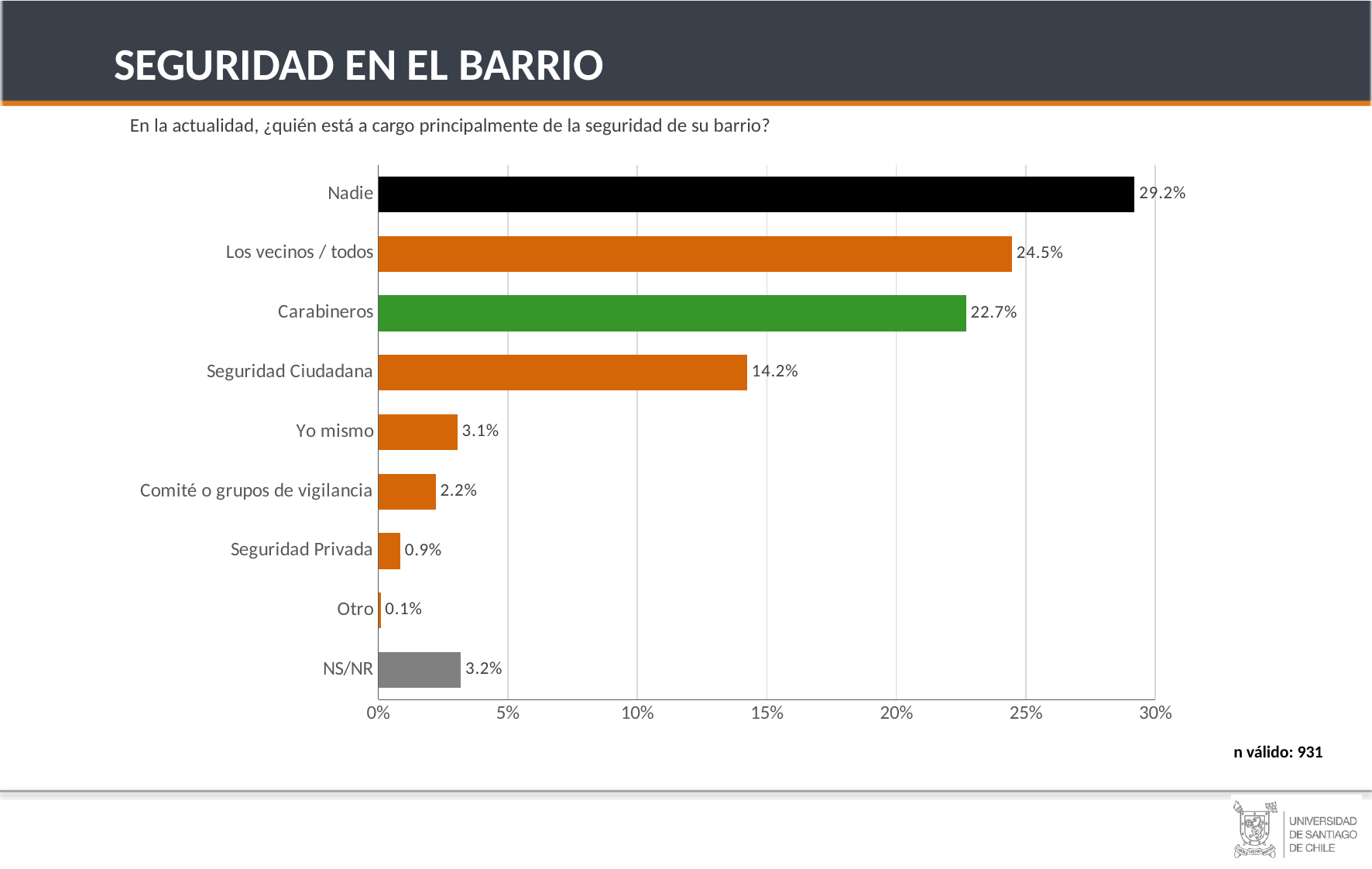
What kind of chart is shown on the slide? bar chart What is the difference between the values for "Nadie" and "Los vecinos / todos"? 4.7% Is the value for "Seguridad Ciudadana" greater or less than 15%? less What is the value shown for "Carabineros"? 22.7% What is the value shown for "Seguridad Ciudadana"? 14.2% Which category has the lowest value? Otro What is the value shown for "NS/NR"? 3.2% How many categories are shown in the chart? 9 Which is larger, the value for "Yo mismo" or the value for "Comité o grupos de vigilancia"? Yo mismo Which category has the highest value? Nadie What percentage of respondents answered "Nadie"? 29.2% What colour is the bar for "Carabineros"? green